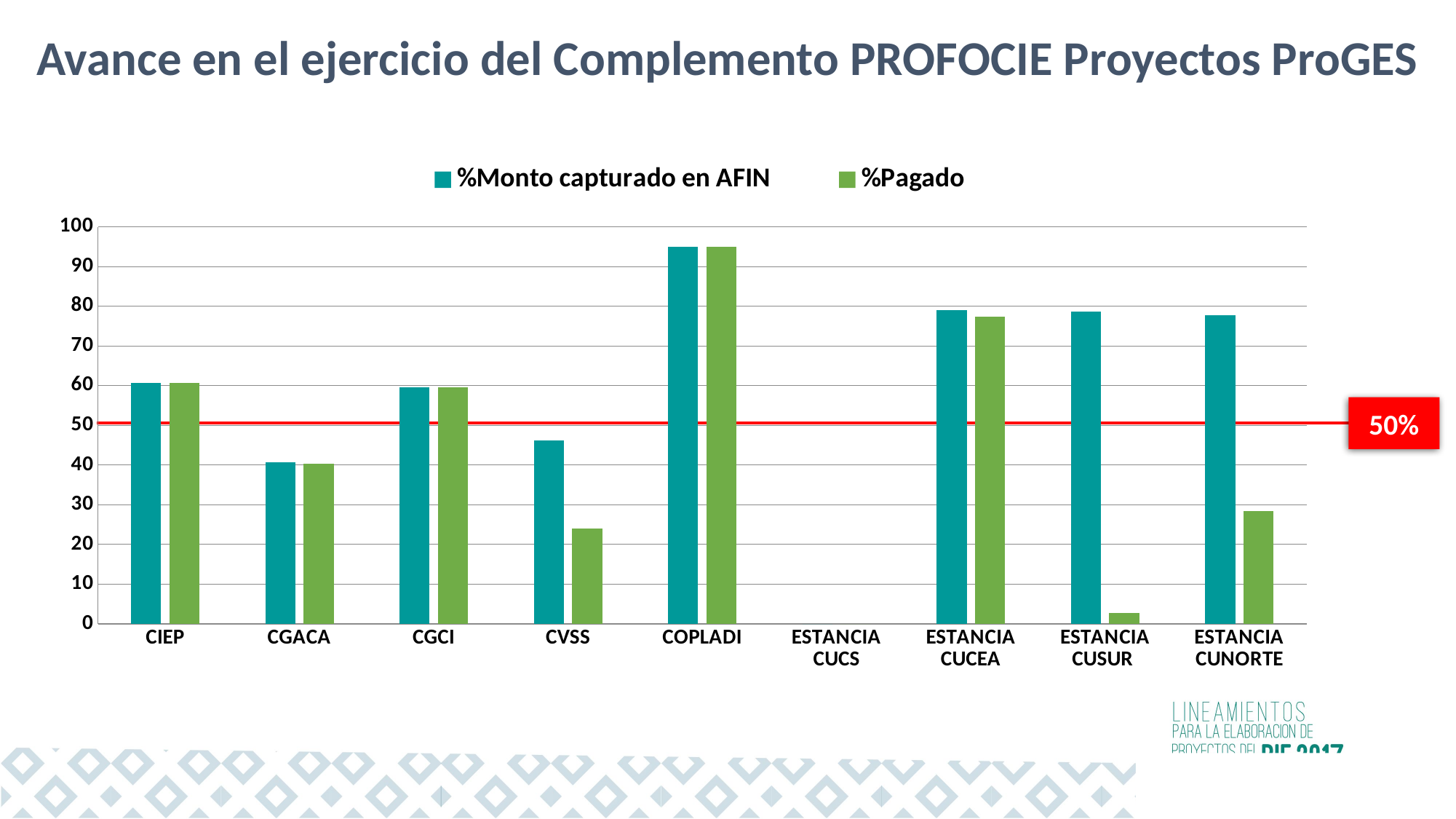
How many series does the legend list? 2 What kind of chart is shown on the slide? bar chart Is the %Pagado value for ESTANCIA CUCEA greater or less than 70? greater For CVSS, which is larger: %Monto capturado en AFIN or %Pagado? %Monto capturado en AFIN For ESTANCIA CUNORTE, which is larger: %Monto capturado en AFIN or %Pagado? %Monto capturado en AFIN What value does the red horizontal reference line mark on the chart? 50% Is the %Monto capturado en AFIN value for CVSS greater or less than 50? less Which category has the highest value for %Monto capturado en AFIN? COPLADI How many categories are shown on the x axis? 9 Which category has the highest value for %Pagado? COPLADI Is the %Monto capturado en AFIN value for COPLADI greater or less than 90? greater